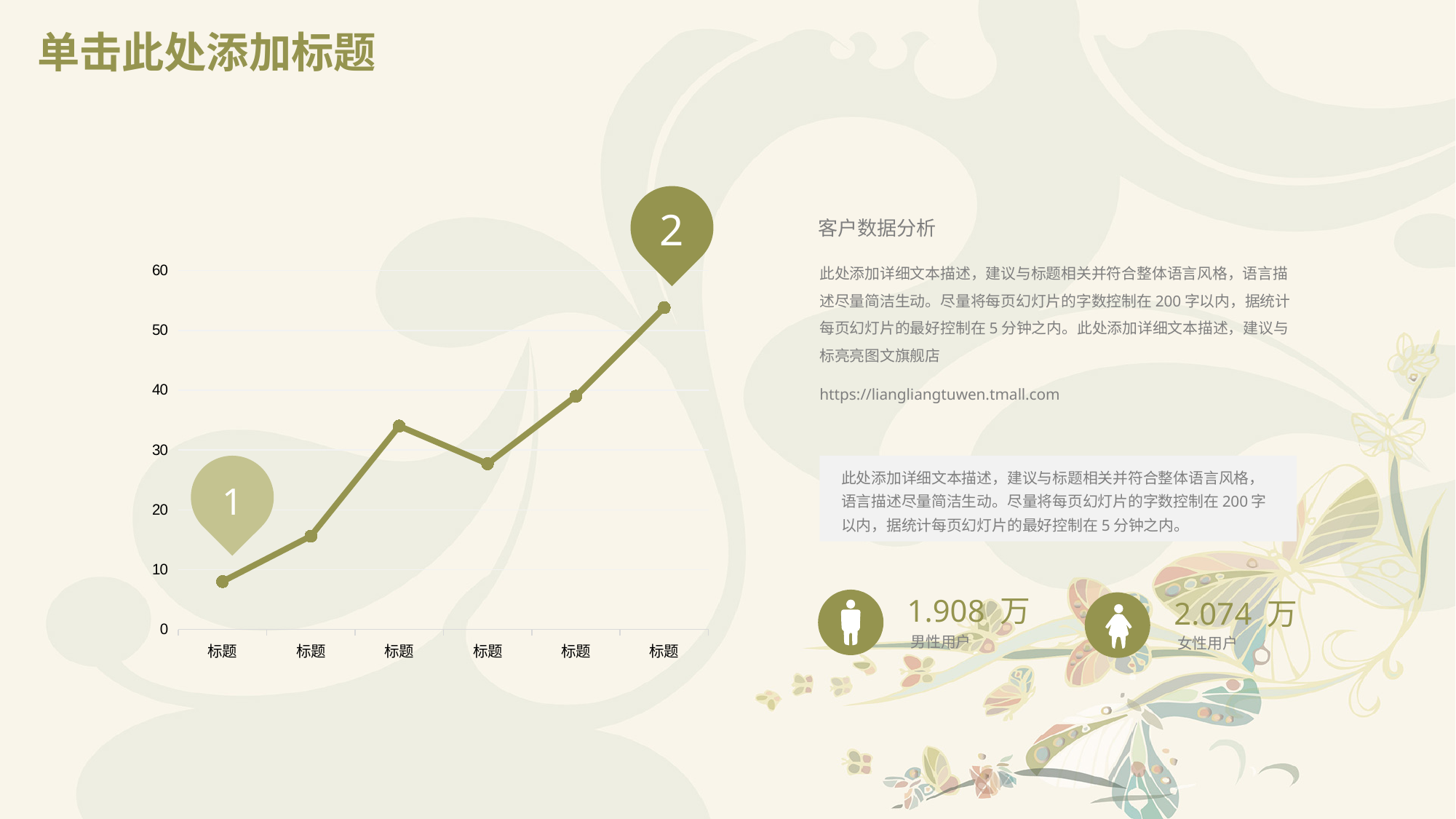
Is the value of the third point on the line chart greater or less than 30? greater How many data points are plotted on the line chart? 6 Which data point on the line chart has the highest value? the sixth (last) point What is the highest value shown on the y axis of the line chart? 60 Which is larger on the line chart, the third point or the fourth point? the third point Is the value of the last point on the line chart greater or less than 50? greater How many categories are shown on the x axis of the line chart? 6 Overall, do the values on the line chart rise or fall from left to right? rise Is the value of the fourth point on the line chart greater or less than 30? less Which data point on the line chart has the lowest value? the first point What kind of chart is shown on the slide? line chart